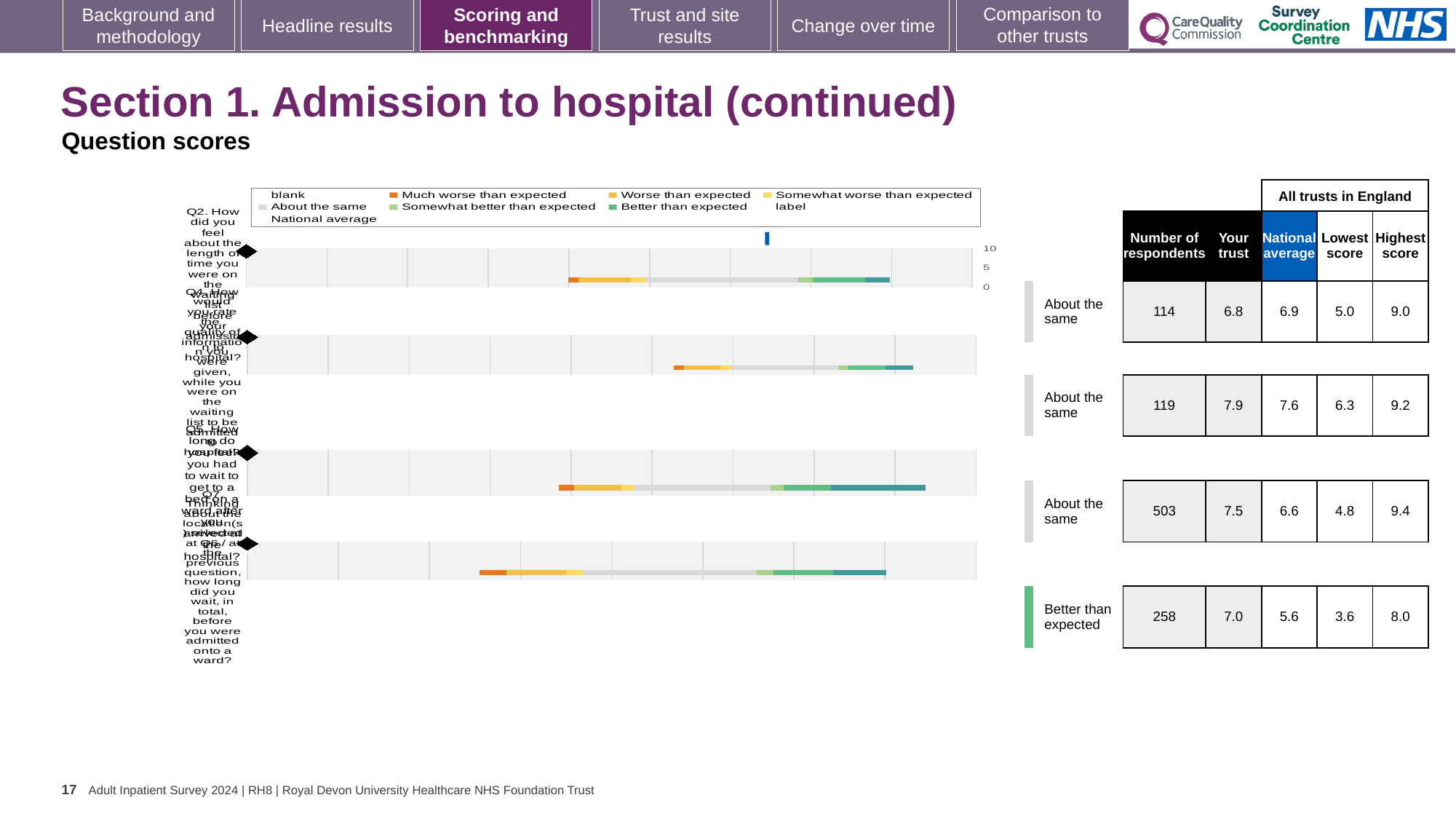
What is the maximum value shown on the chart's score axis? 10 What kind of chart is shown on the slide? bar chart In the table beside the chart, what is the highest score for the fourth (bottom) question row? 8.0 For the fourth (bottom) question row, what is the difference between the 'Your trust' score and the national average? 1.4 For the first (top) question row, which is larger: the 'Your trust' score or the national average? national average How many entries does the chart legend list? 9 How many of the question rows are rated 'About the same'? 3 In the table beside the chart, what is the number of respondents for the first (top) question row? 114 Which question row has the largest number of respondents? the third row (503) In the table beside the chart, what is the national average for the third question row? 6.6 How many question rows are plotted in the chart? 4 In the table beside the chart, what is the 'Your trust' score for the second question row? 7.9